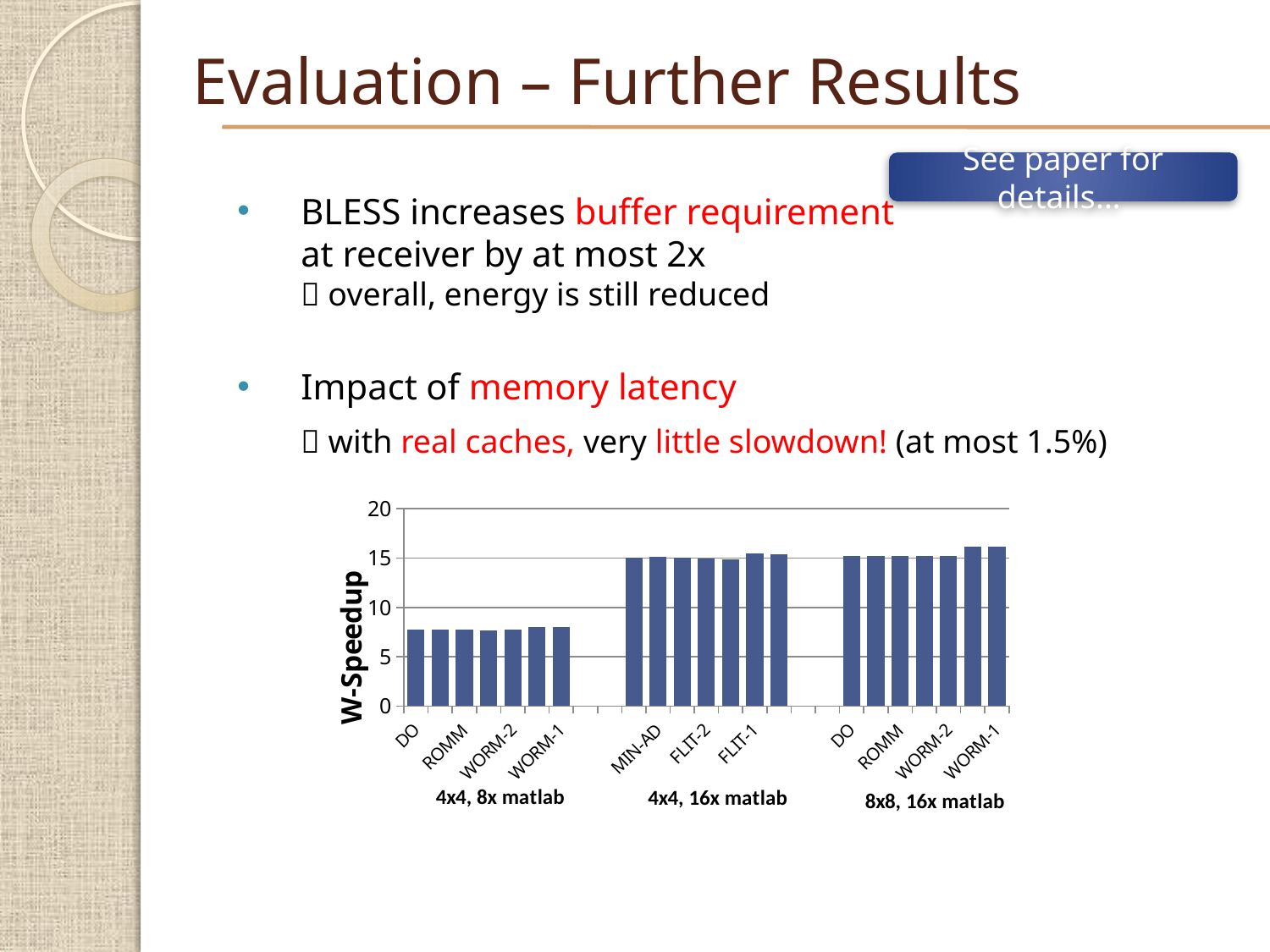
Which is larger: the value for WORM-1 in the 4x4, 8x matlab group or the value for MIN-AD in the 4x4, 16x matlab group? MIN-AD in the 4x4, 16x matlab group How many configuration groups (labelled below the x axis) does the chart show? 3 What is the label of the vertical axis of the chart? W-Speedup Which configuration group has the lowest bars in the chart? 4x4, 8x matlab Is the value for DO in the 4x4, 8x matlab group greater or less than 5? greater How many bars are in the 4x4, 8x matlab group? 7 Is the value for DO in the 4x4, 8x matlab group greater or less than 10? less Which configuration group contains the tallest bar in the chart? 8x8, 16x matlab Is the value for MIN-AD in the 4x4, 16x matlab group greater or less than 10? greater What kind of chart is shown on the slide? bar chart Which is larger: the value for DO in the 4x4, 8x matlab group or the value for DO in the 8x8, 16x matlab group? DO in the 8x8, 16x matlab group